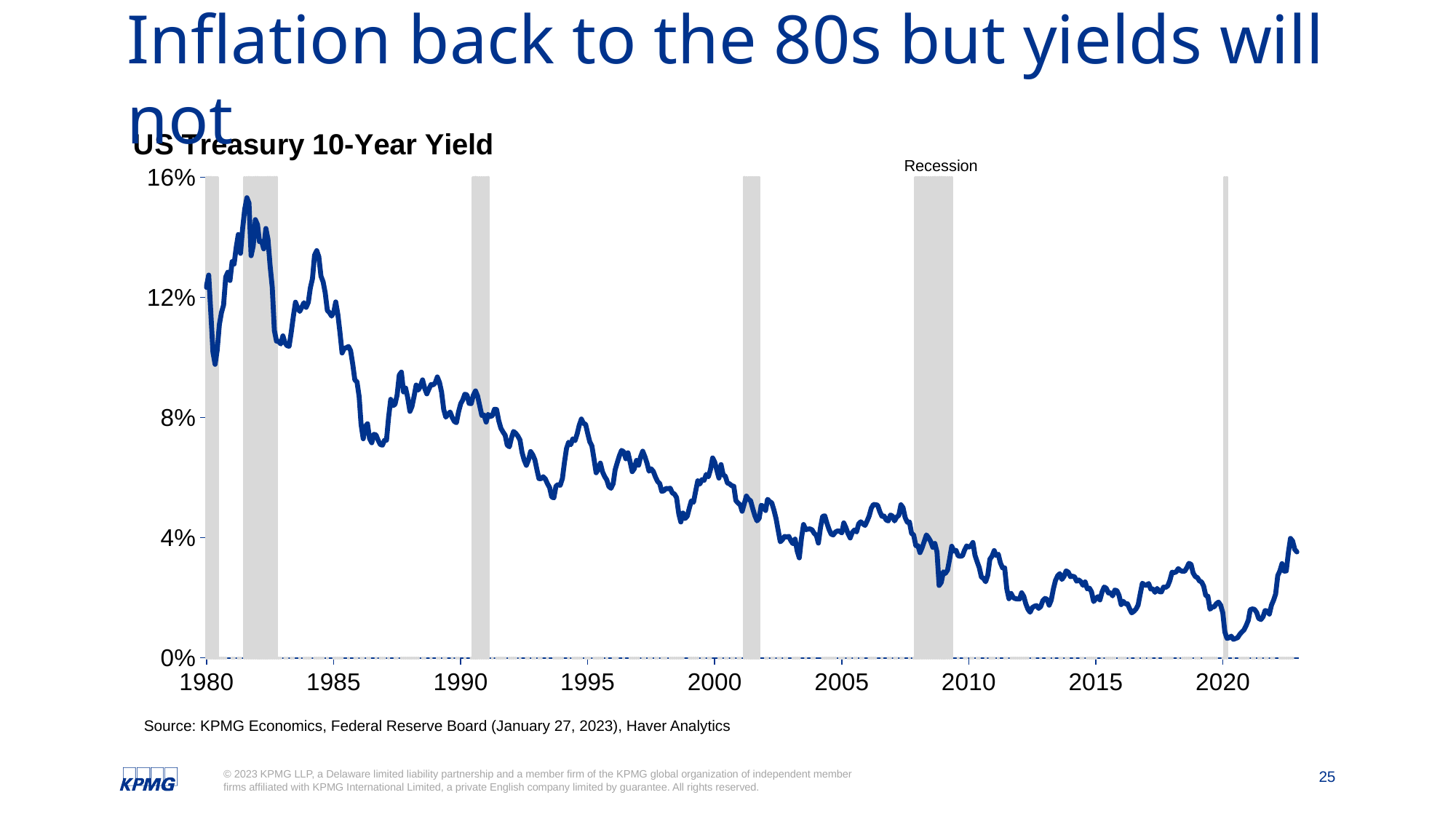
In roughly which period does the yield reach its highest point? early 1980s Overall, does the US Treasury 10-Year Yield rise or fall from 1980 to 2020? fall Which is higher, the yield in 1985 or the yield in 2015? 1985 Is the yield in 1995 greater or less than 4%? greater Is the yield at the start of 1980 greater or less than 8%? greater Is the yield in 2010 greater or less than 8%? less In roughly which year does the yield reach its lowest point? 2020 What is the title of the chart? US Treasury 10-Year Yield What kind of chart is shown on the slide? line chart What do the grey shaded bands on the chart represent? Recession